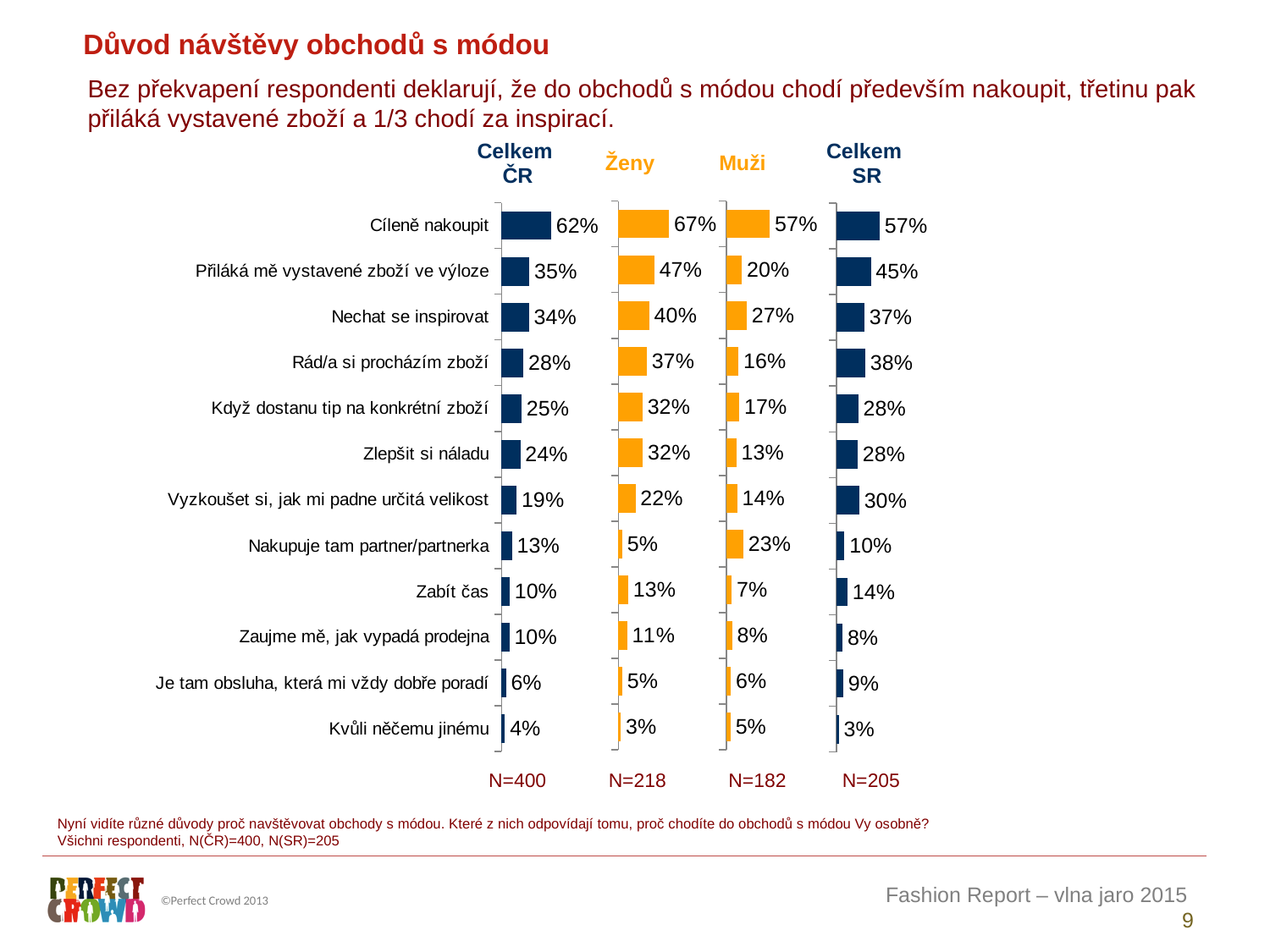
In the Muži chart, what is the value for Nakupuje tam partner/partnerka? 23% In the Muži chart, which category has the highest value? Cíleně nakoupit For Nakupuje tam partner/partnerka, which is larger: the Ženy value or the Muži value? Muži What is the sample size (N) shown under the Celkem SR chart? N=205 What is the difference between the Ženy and Muži values for Přiláká mě vystavené zboží ve výloze? 27% What type of chart is used on this slide? Bar chart How many categories are shown in the Celkem ČR chart? 12 In the Ženy chart, which category has the lowest value? Kvůli něčemu jinému In the Celkem ČR chart, what is the value for Cíleně nakoupit? 62% In the Celkem SR chart, what is the value for Rád/a si procházím zboží? 38% In the Ženy chart, what is the value for Přiláká mě vystavené zboží ve výloze? 47% What is the difference between the Celkem ČR and Celkem SR values for Vyzkoušet si, jak mi padne určitá velikost? 11%